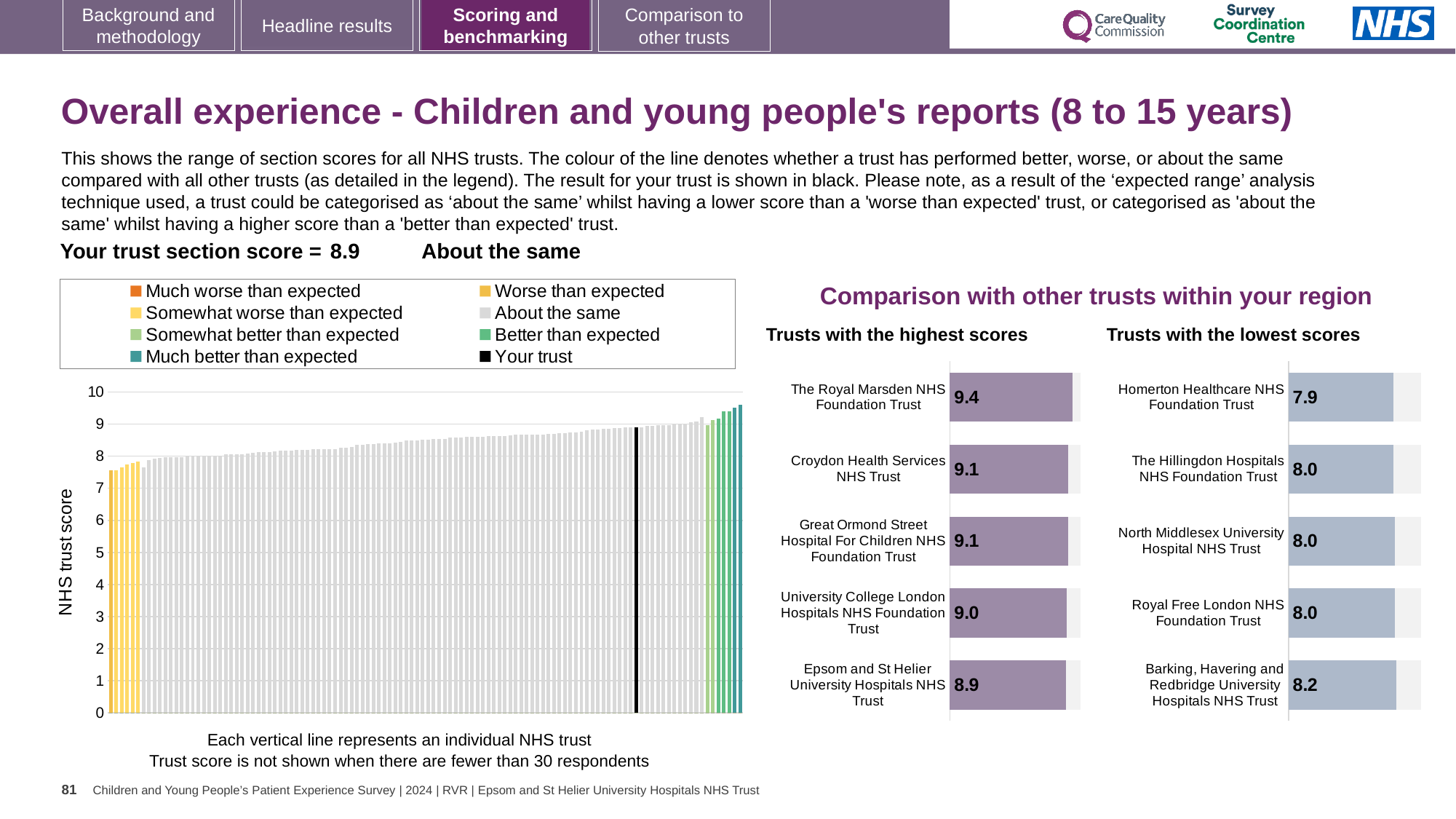
In the large chart on the left showing all NHS trusts, is the value for the black bar (your trust) greater or less than 8? greater In the 'Trusts with the lowest scores' chart, which trust has the lowest score? Homerton Healthcare NHS Foundation Trust In the 'Trusts with the highest scores' chart, what is the score for The Royal Marsden NHS Foundation Trust? 9.4 In the 'Trusts with the lowest scores' chart, what is the score for Homerton Healthcare NHS Foundation Trust? 7.9 What kind of chart is the large chart on the left showing NHS trust scores? Bar chart How many trusts are shown in the 'Trusts with the lowest scores' chart? 5 In the 'Trusts with the highest scores' chart, which has the larger score: Croydon Health Services NHS Trust or University College London Hospitals NHS Foundation Trust? Croydon Health Services NHS Trust In the 'Trusts with the highest scores' chart, what is the difference between the scores of The Royal Marsden NHS Foundation Trust and Epsom and St Helier University Hospitals NHS Trust? 0.5 In the 'Trusts with the lowest scores' chart, what is the difference between the scores of Barking, Havering and Redbridge University Hospitals NHS Trust and Homerton Healthcare NHS Foundation Trust? 0.3 In the 'Trusts with the highest scores' chart, what is the score for University College London Hospitals NHS Foundation Trust? 9.0 In the 'Trusts with the lowest scores' chart, what is the score for Barking, Havering and Redbridge University Hospitals NHS Trust? 8.2 In the 'Trusts with the highest scores' chart, which trust has the highest score? The Royal Marsden NHS Foundation Trust